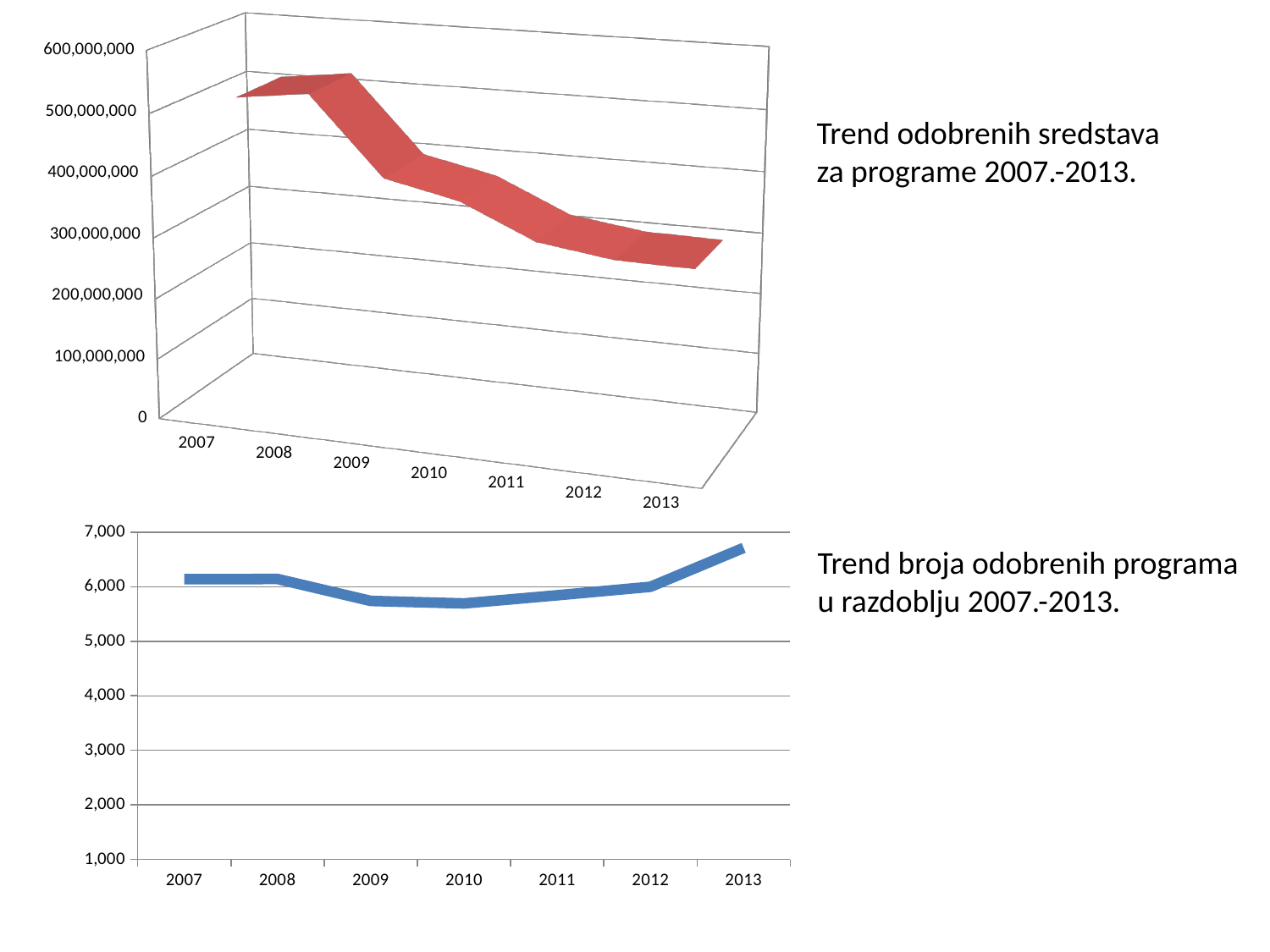
In the top chart (Trend odobrenih sredstava za programe 2007.-2013.), do the values generally rise or fall from 2007 to 2013? fall What is the title text shown next to the top chart? Trend odobrenih sredstava za programe 2007.-2013. In the bottom chart (Trend broja odobrenih programa u razdoblju 2007.-2013.), is the value for 2010 greater or less than 6,000? less How many years are shown on the x axis of the top chart (Trend odobrenih sredstava za programe 2007.-2013.)? 7 In the top chart (Trend odobrenih sredstava za programe 2007.-2013.), which is larger, the value for 2008 or the value for 2011? 2008 In the top chart (Trend odobrenih sredstava za programe 2007.-2013.), is the value for 2013 greater or less than 400,000,000? less In the bottom chart (Trend broja odobrenih programa u razdoblju 2007.-2013.), which is larger, the value for 2013 or the value for 2009? 2013 In the bottom chart (Trend broja odobrenih programa u razdoblju 2007.-2013.), is the value for 2013 greater or less than 6,000? greater What kind of chart is the bottom chart (Trend broja odobrenih programa u razdoblju 2007.-2013.)? line chart How many data points are plotted in the bottom chart (Trend broja odobrenih programa u razdoblju 2007.-2013.)? 7 In the bottom chart (Trend broja odobrenih programa u razdoblju 2007.-2013.), which year has the highest value? 2013